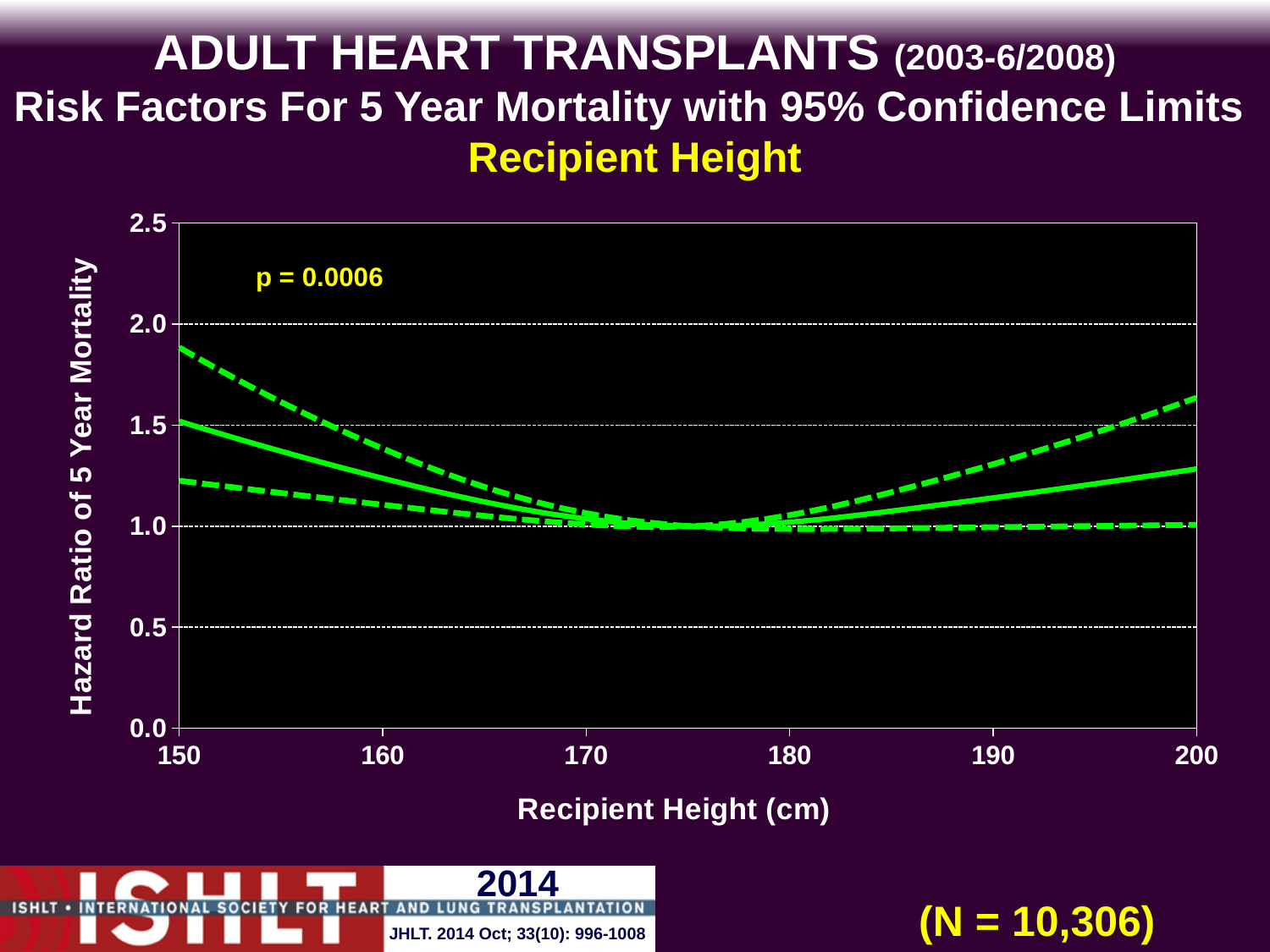
Does the solid hazard ratio line rise or fall as recipient height increases from 150 cm to 170 cm? fall What p-value is printed on the chart? p = 0.0006 Is the hazard ratio of the solid line at a recipient height of 150 cm greater or less than 1.0? greater What is the sample size (N) shown on the slide? N = 10,306 Is the hazard ratio of the solid line at a recipient height of 200 cm greater or less than 1.5? less How many lines are plotted on the chart? 3 Is the lower dashed confidence limit at a recipient height of 200 cm greater or less than 1.5? less What is the label of the y axis? Hazard Ratio of 5 Year Mortality What is the label of the x axis? Recipient Height (cm) Does the solid hazard ratio line rise or fall as recipient height increases from 180 cm to 200 cm? rise What kind of chart is shown on the slide? line chart